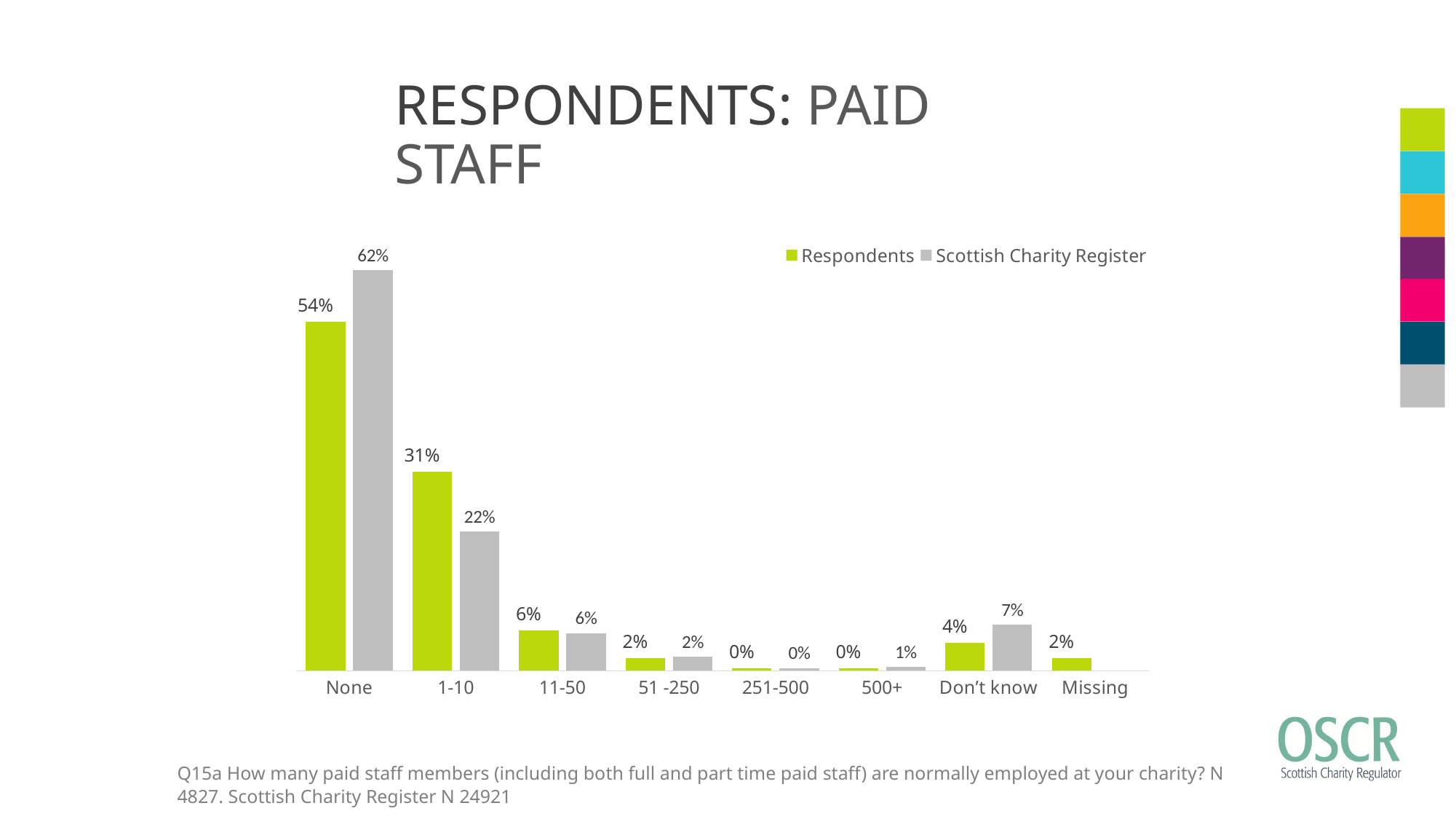
What is the difference between the Respondents and Scottish Charity Register values for 1-10? 9% What is the Respondents value for Missing? 2% What is the Scottish Charity Register value for Don't know? 7% Which colour represents the Respondents series? Green What is the Scottish Charity Register value for the 1-10 category? 22% Which category has the highest Scottish Charity Register value? None What kind of chart is shown on the slide? Bar chart What is the difference between the Scottish Charity Register and Respondents values for None? 8% For the 1-10 category, which series has the larger value, Respondents or Scottish Charity Register? Respondents What is the Respondents value for the None category? 54% How many categories are shown on the x axis? 8 How many series does the legend list? 2